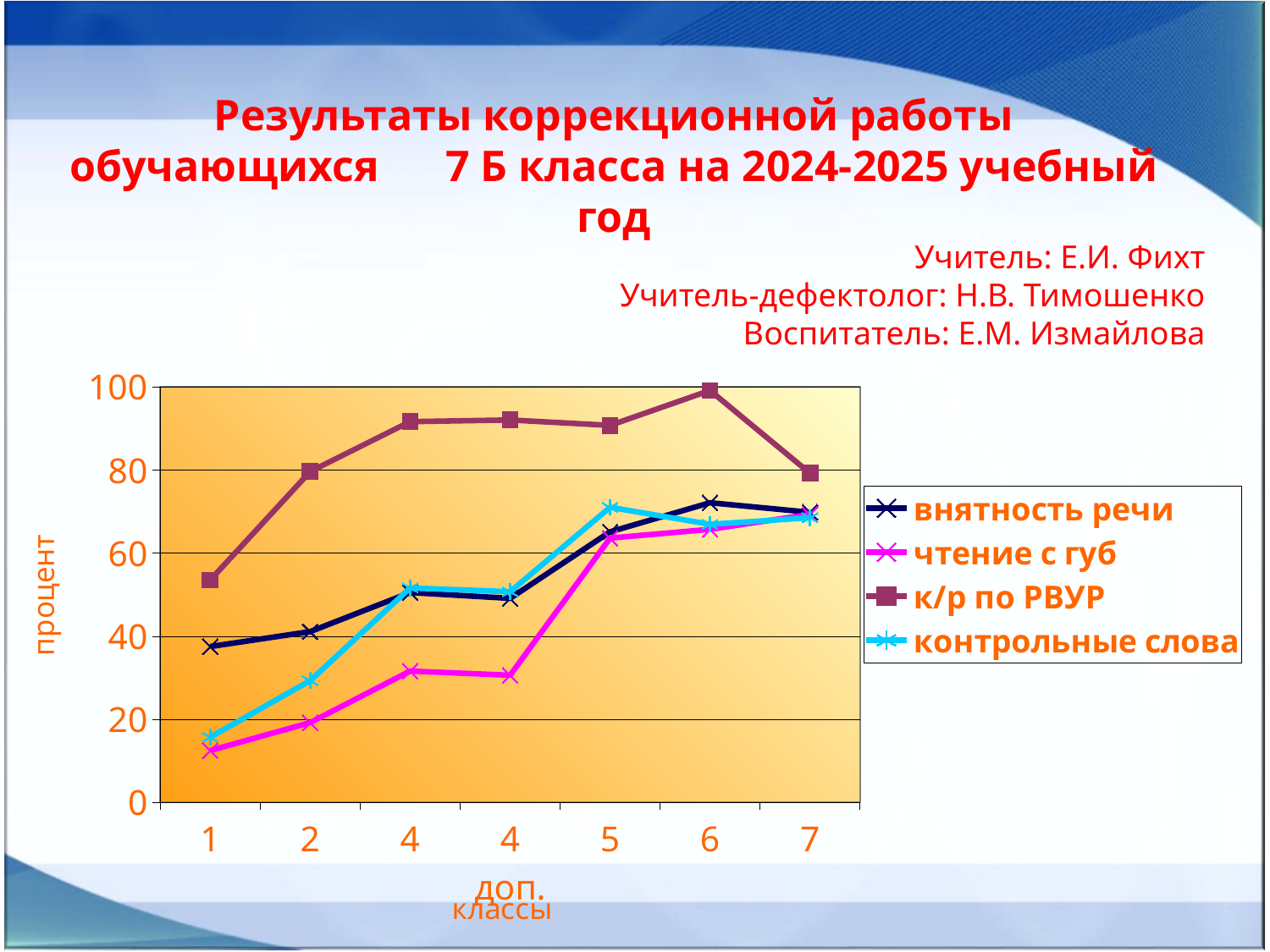
At which x category does the series чтение с губ reach its lowest value? 1 Is the value for к/р по РВУР at x category 6 greater or less than 80? greater At x category 1, which is larger: к/р по РВУР or внятность речи? к/р по РВУР Is the value for контрольные слова at x category 5 greater or less than 60? greater Is the value for внятность речи at x category 1 greater or less than 40? less Does the series чтение с губ rise or fall from x category 1 to x category 5? rise How many points are plotted along the x axis for each series? 7 What is the title of the vertical axis? процент Which series has the highest value at x category 6? к/р по РВУР What kind of chart is shown on the slide? line chart How many series does the legend list? 4